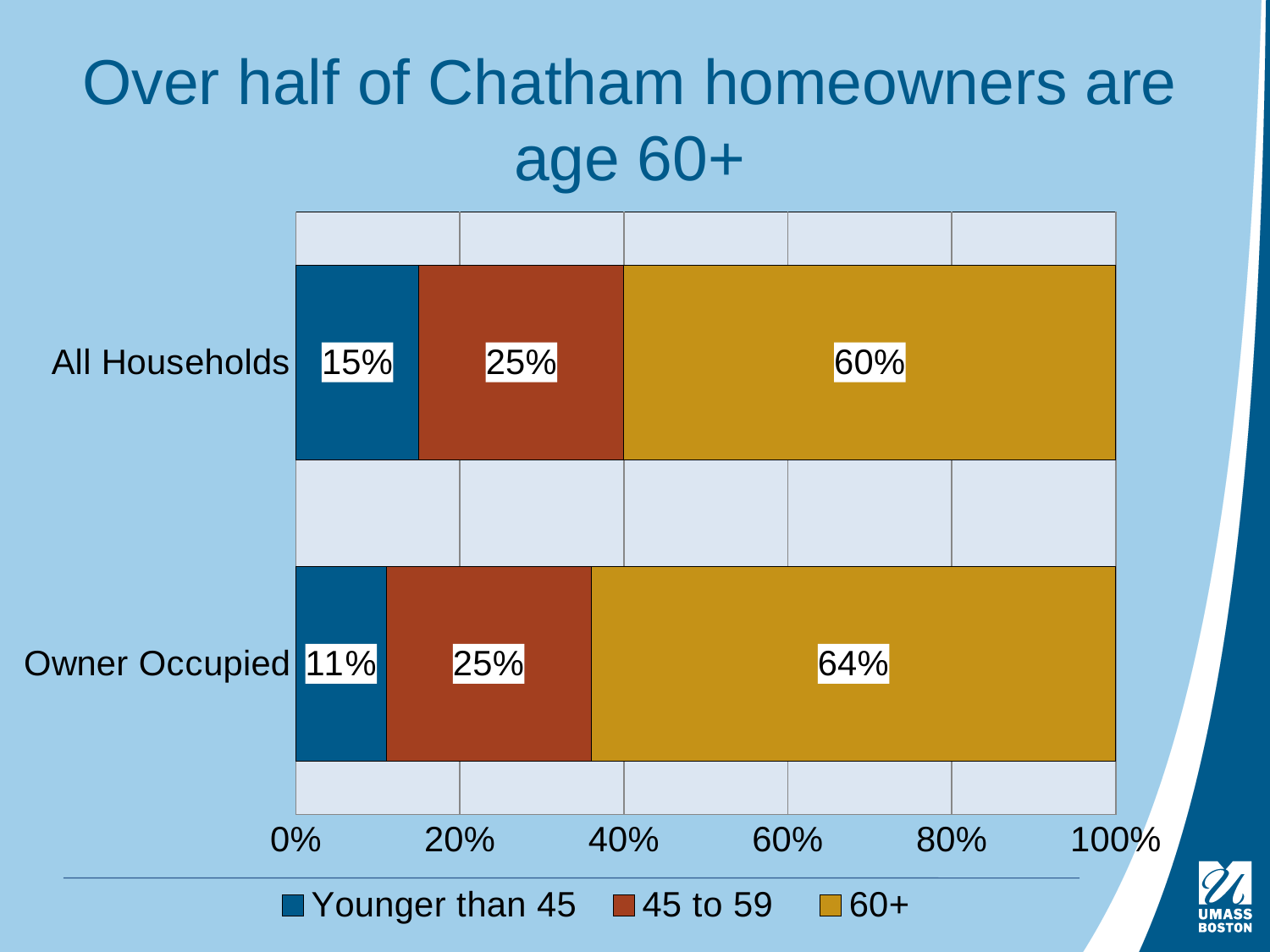
What is the difference between the 60+ share for Owner Occupied and for All Households? 4% Which age group has the smallest share among All Households? Younger than 45 What percentage of All Households are age 60+? 60% What is the total of the stacked bar for Owner Occupied? 100% Which category has a larger Younger than 45 share, All Households or Owner Occupied? All Households Which age group has the largest share among Owner Occupied households? 60+ How many series does the legend list? 3 What percentage of Owner Occupied households are Younger than 45? 11% How many categories are shown on the y axis? 2 What kind of chart is shown on the slide? Stacked bar chart What percentage of All Households are aged 45 to 59? 25% What percentage of Owner Occupied households are age 60+? 64%